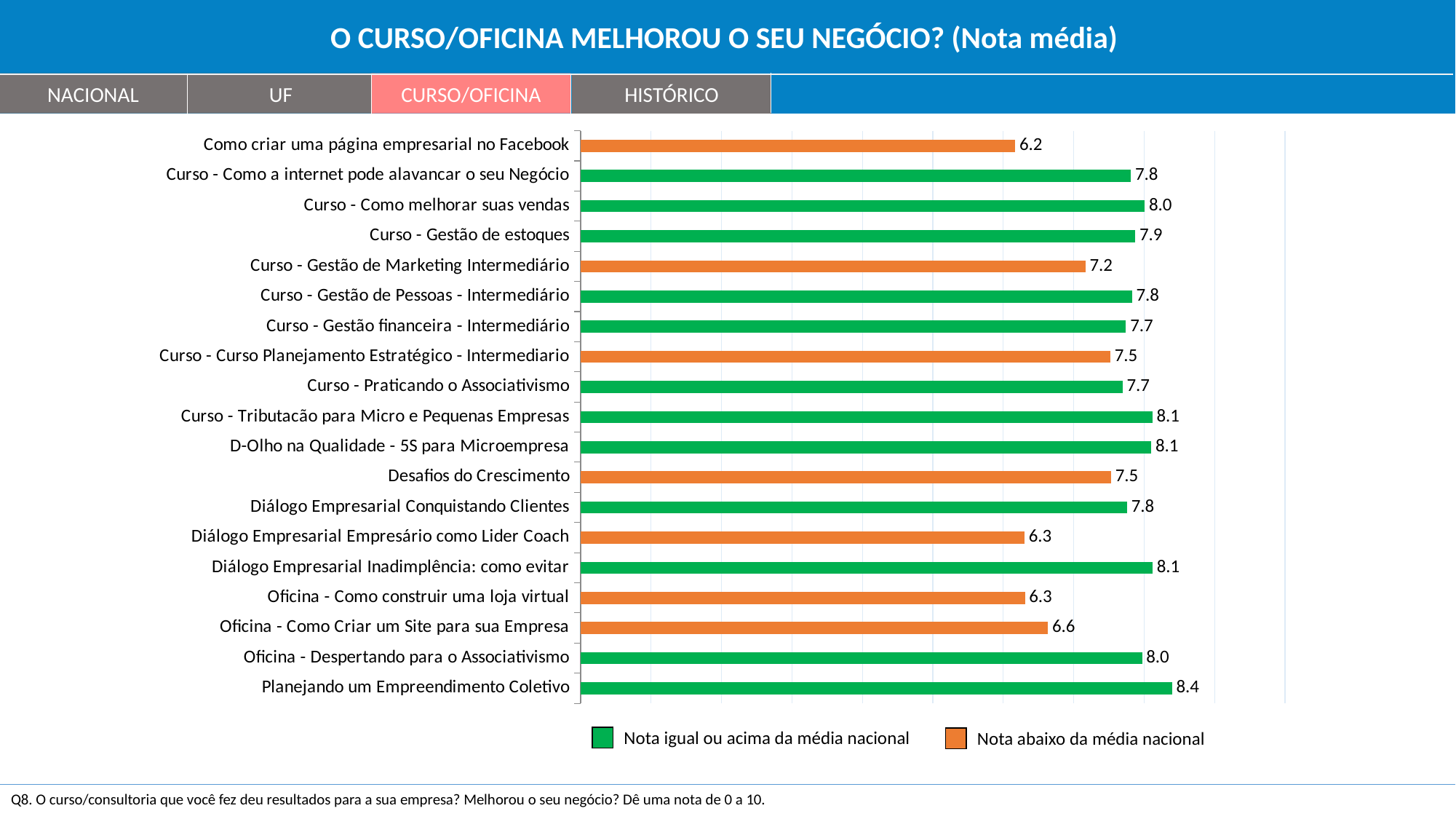
How many courses/workshops are shown in the chart? 19 Which has a higher score: "Curso - Gestão de estoques" or "Desafios do Crescimento"? Curso - Gestão de estoques What is the average score for "Oficina - Como Criar um Site para sua Empresa"? 6.6 What is the average score for "Planejando um Empreendimento Coletivo"? 8.4 What is the average score for "Curso - Gestão de Marketing Intermediário"? 7.2 How many bars are coloured orange (below the national average)? 7 What does the green colour in the legend represent? Nota igual ou acima da média nacional Which course/workshop has the highest average score? Planejando um Empreendimento Coletivo How many entries does the legend list? 2 What is the difference between the scores for "Planejando um Empreendimento Coletivo" and "Como criar uma página empresarial no Facebook"? 2.2 Which course/workshop has the lowest average score? Como criar uma página empresarial no Facebook What type of chart is shown on the slide? Bar chart